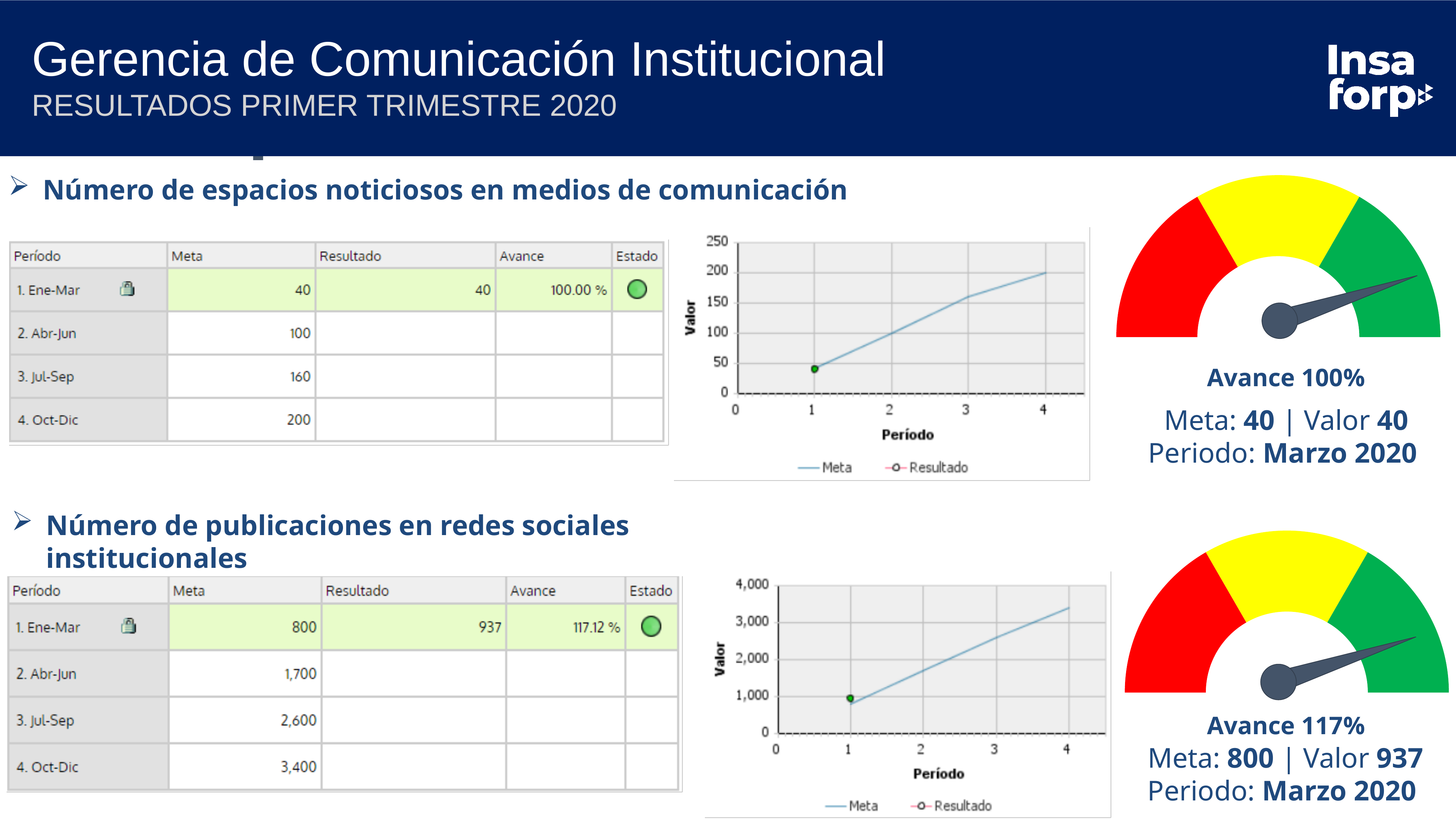
What is the label of the vertical axis in the lower line chart? Valor What Avance percentage is shown under the lower gauge chart? 117% In the lower line chart (publicaciones en redes sociales), is the Meta value at period 4 greater or less than 3,000? greater How many series does the legend of the upper line chart list? 2 In the upper line chart, what is the Meta value at period 2? 100 What kind of chart is the upper chart next to the 'Número de espacios noticiosos en medios de comunicación' table? Line chart In the lower line chart, does the Meta line rise or fall along the Período axis? Rises In the upper line chart, is the Meta value at period 1 greater or less than 50? less In the upper line chart, does the Meta line rise or fall from period 1 to period 4? Rises What are the two legend entries of the upper line chart? Meta and Resultado In the upper line chart, what is the Meta value at period 4? 200 In the lower line chart, is the Resultado point at period 1 greater or less than 2,000? less